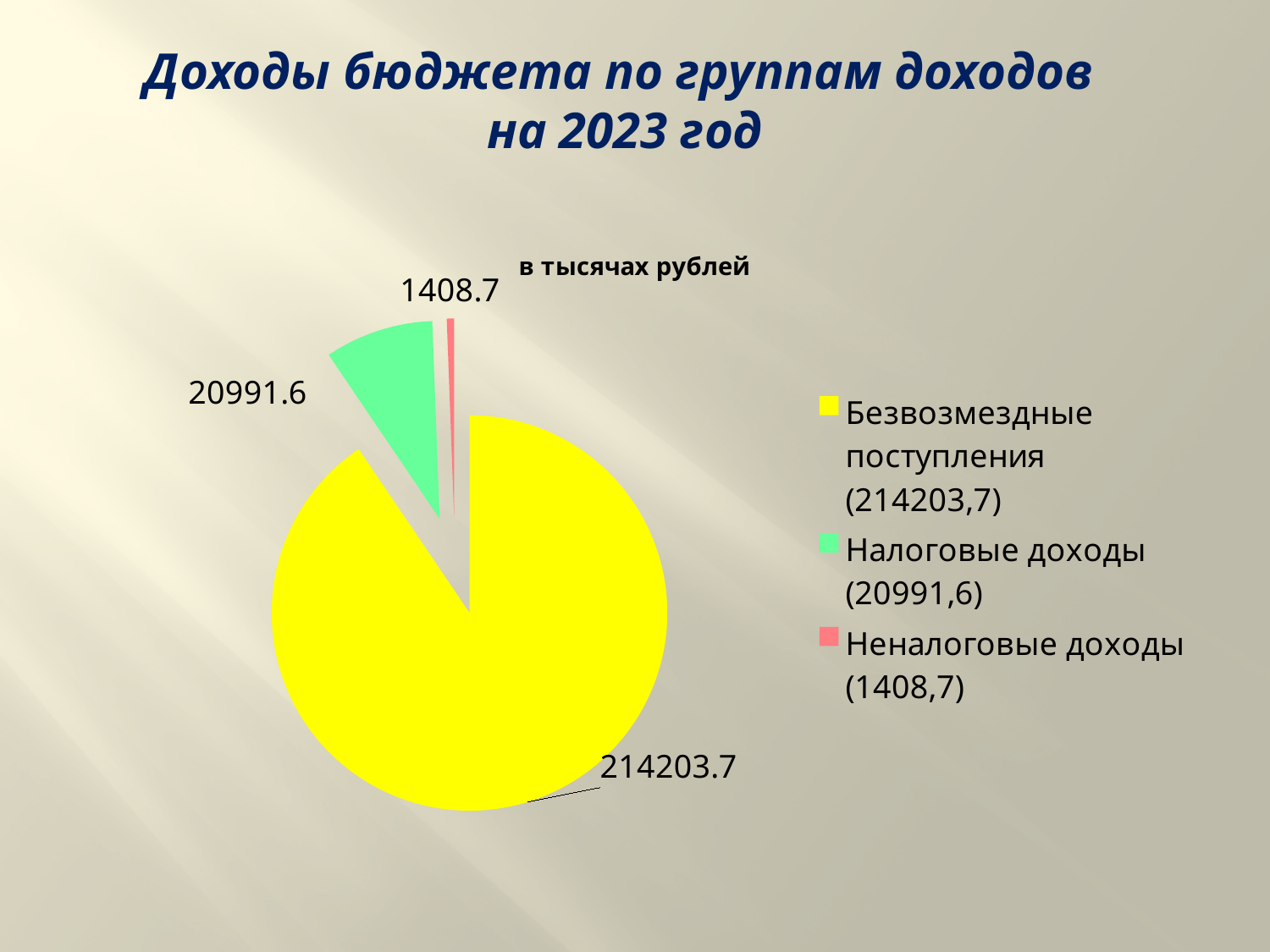
Which is larger, Налоговые доходы or Неналоговые доходы? Налоговые доходы What is the difference between Безвозмездные поступления and Налоговые доходы? 193212.1 What colour is the slice for Налоговые доходы? green What is the value for Безвозмездные поступления? 214203.7 What unit is stated in the chart title above the pie? в тысячах рублей How many slices does the pie chart have? 3 What is the value for Налоговые доходы? 20991.6 Which category has the largest slice of the pie? Безвозмездные поступления What type of chart is shown on the slide? pie chart What is the difference between Налоговые доходы and Неналоговые доходы? 19582.9 Which category has the smallest slice of the pie? Неналоговые доходы What is the value for Неналоговые доходы? 1408.7